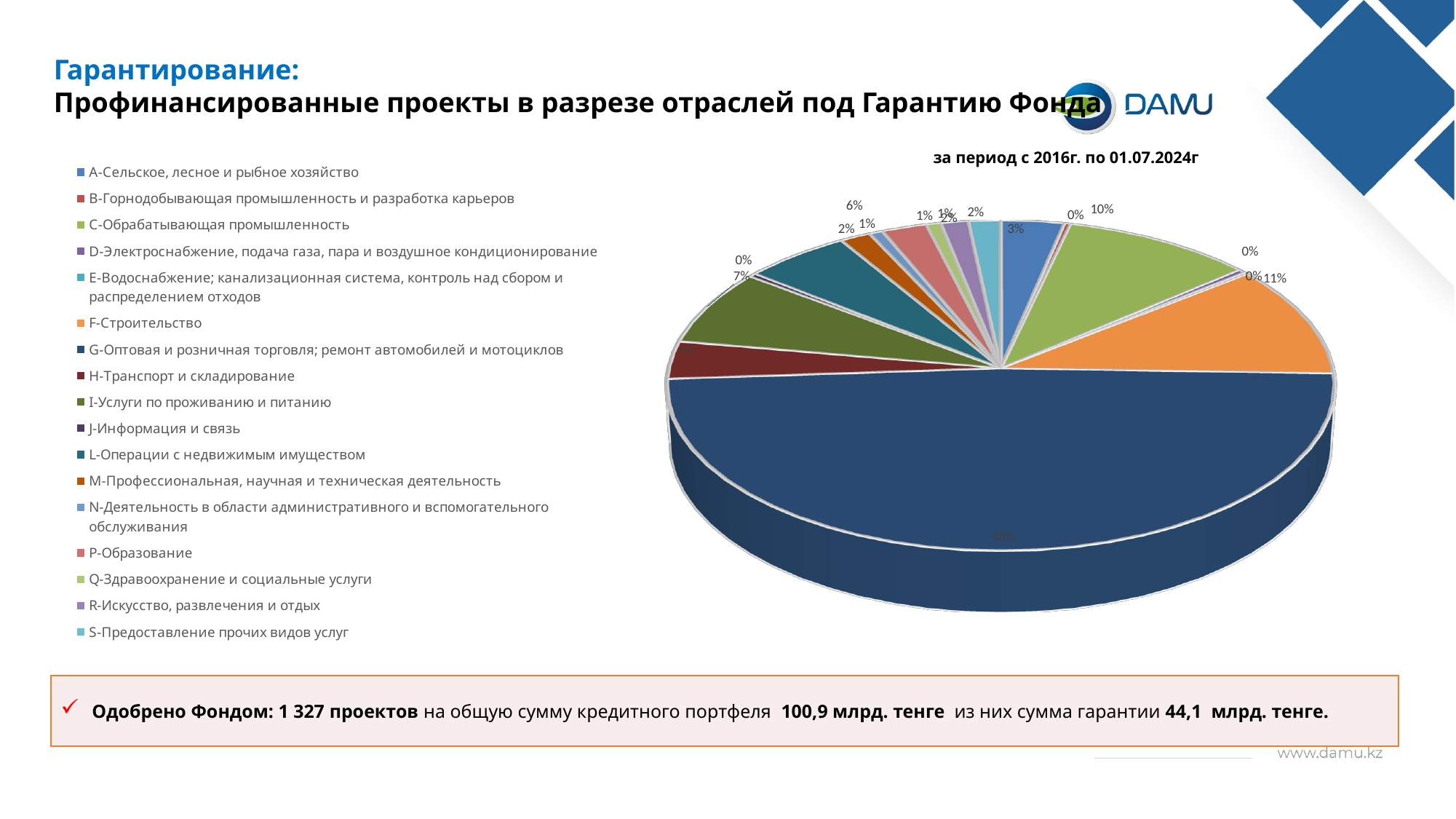
What kind of chart is shown on the slide? pie chart How many categories does the legend of the pie chart list? 17 Which has a larger share: F-Строительство or C-Обрабатывающая промышленность? F-Строительство What share of the pie does A-Сельское, лесное и рыбное хозяйство have? 3% What share of the pie does F-Строительство have? 11% What colour is used for G-Оптовая и розничная торговля; ремонт автомобилей и мотоциклов in the pie chart? dark blue Which category has the largest slice of the pie chart? G-Оптовая и розничная торговля; ремонт автомобилей и мотоциклов What share of the pie does C-Обрабатывающая промышленность have? 10% What period does the pie chart cover, according to the label above it? за период с 2016г. по 01.07.2024г What share of the pie does I-Услуги по проживанию и питанию have? 7% What is the difference in share between F-Строительство (11%) and C-Обрабатывающая промышленность (10%)? 1% What share of the pie does L-Операции с недвижимым имуществом have? 6%